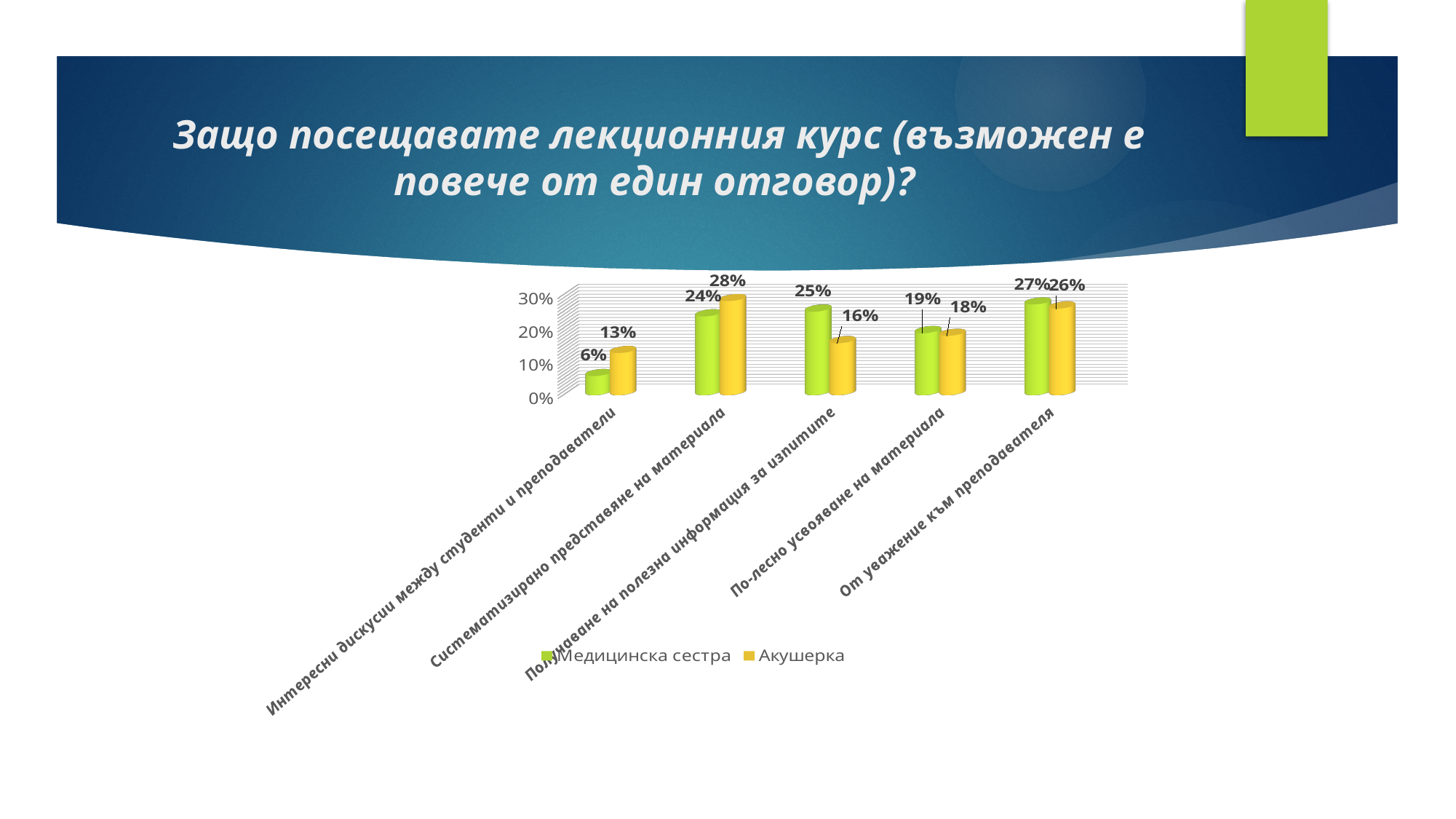
What is the value for Медицинска сестра in the category "По-лесно усвояване на материала"? 19% In the category "Получаване на полезна информация за изпитите", which series has the larger value, Медицинска сестра or Акушерка? Медицинска сестра Which colour represents the series Акушерка in the chart? Yellow Which category has the lowest value for Акушерка? Интересни дискусии между студенти и преподаватели What is the value for Акушерка in the category "От уважение към преподавателя"? 26% What is the difference between the Акушерка and Медицинска сестра values in the category "Интересни дискусии между студенти и преподаватели"? 7% How many categories are shown on the x axis of the chart? 5 What is the value for Медицинска сестра in the category "Интересни дискусии между студенти и преподаватели"? 6% How many series does the chart legend list? 2 What is the value for Акушерка in the category "Систематизирано представяне на материала"? 28% What kind of chart is shown on the slide? Bar chart Which category has the highest value for Медицинска сестра? От уважение към преподавателя